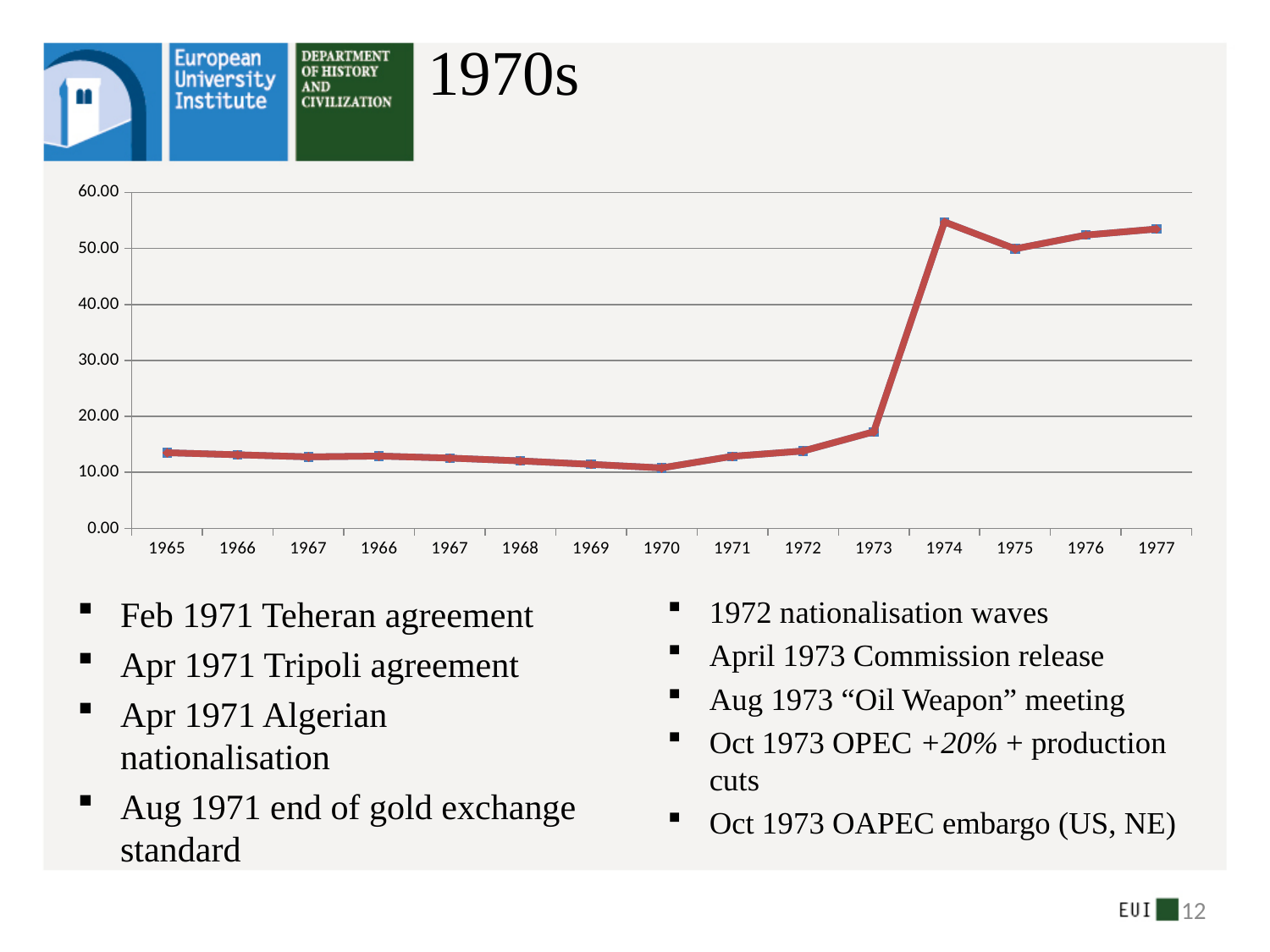
Is the value for 1973 greater or less than 20? less What colour is the line in the chart? red Is the value for 1974 greater or less than 50? greater How many data points are plotted along the x axis of the chart? 15 What is the highest value shown on the y axis of the chart? 60.00 Is the value for 1977 greater or less than 50? greater Which has the larger value, 1973 or 1974? 1974 Which has the larger value, 1975 or 1977? 1977 Which year on the x axis has the highest value in the chart? 1974 What kind of chart is shown on the slide? line chart Does the line rise or fall between 1973 and 1974? rise